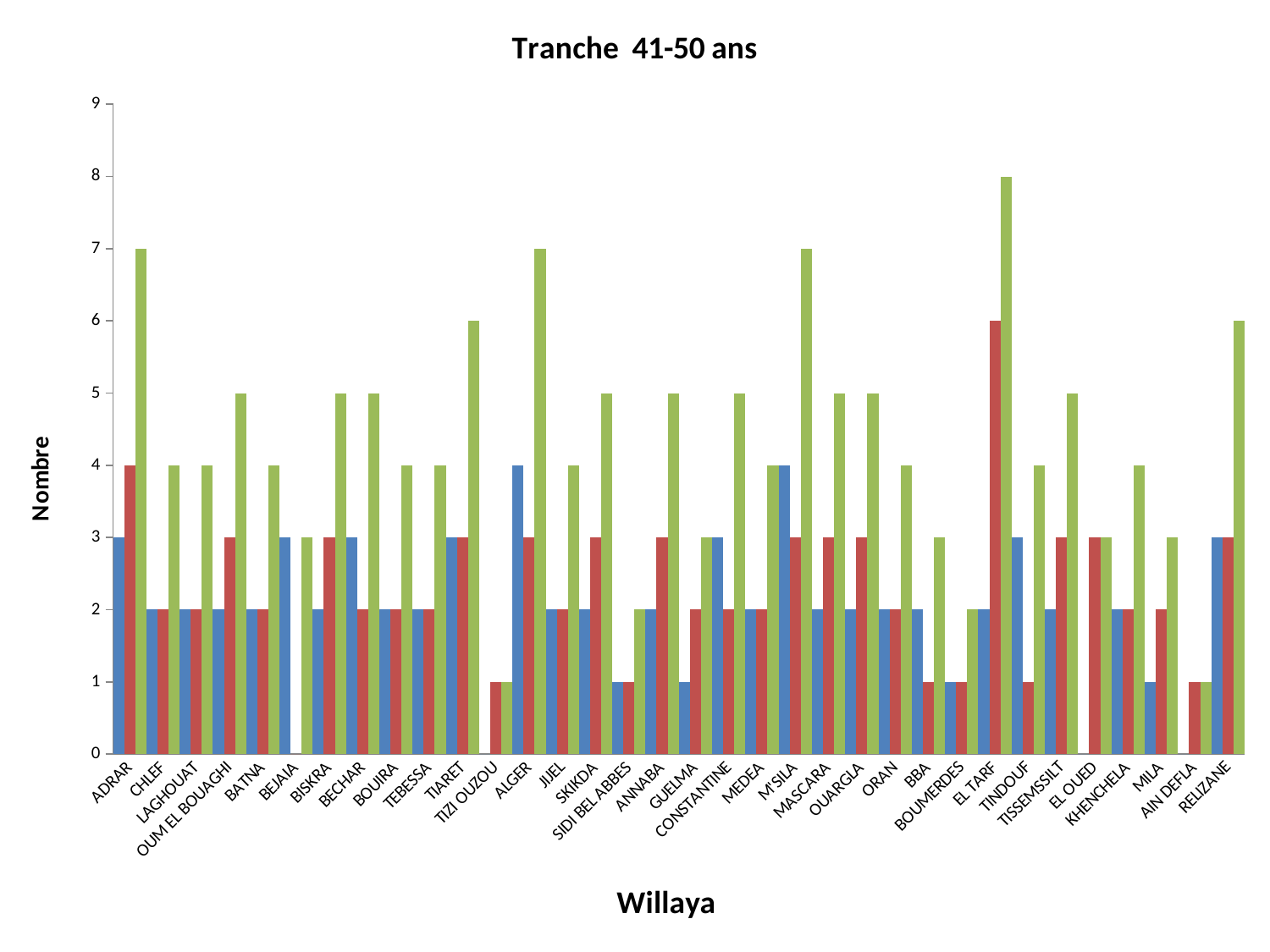
Which willaya has the highest green bar? EL TARF What kind of chart is shown on the slide? bar chart What is the difference between the green bar for EL TARF and the green bar for ADRAR? 1 What is the label of the vertical axis? Nombre What is the title of the chart? Tranche 41-50 ans What is the value of the green bar for TIARET? 6 How many willayas (categories) are shown on the x axis? 34 Is the green bar for M'SILA greater or less than 5? greater What is the value of the blue bar for ALGER? 4 What is the value of the red bar for ADRAR? 4 Which is larger, the red bar for EL TARF or the red bar for TINDOUF? EL TARF What is the value of the green bar for EL TARF? 8